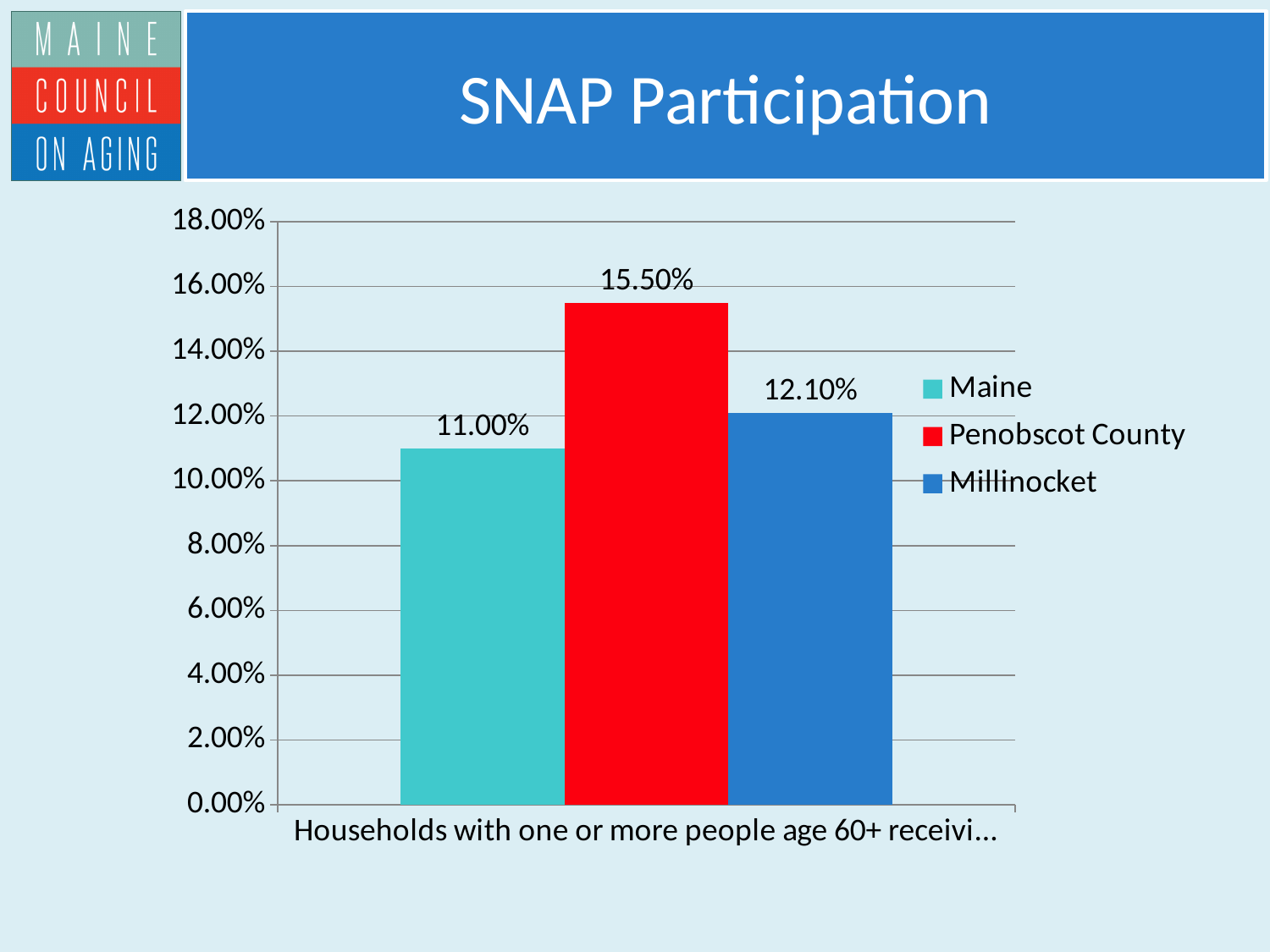
What colour is the bar for Penobscot County? red What is the difference between the values for Penobscot County and Maine? 4.50% Is the value for Penobscot County greater or less than 14.00%? greater Which is larger, the value for Millinocket or the value for Maine? Millinocket What is the value for Penobscot County? 15.50% What kind of chart is shown on the slide? bar chart How many series does the legend list? 3 What is the difference between the values for Millinocket and Maine? 1.10% Which series has the highest value? Penobscot County Which series has the lowest value? Maine What is the value for Millinocket? 12.10% What is the value for Maine? 11.00%